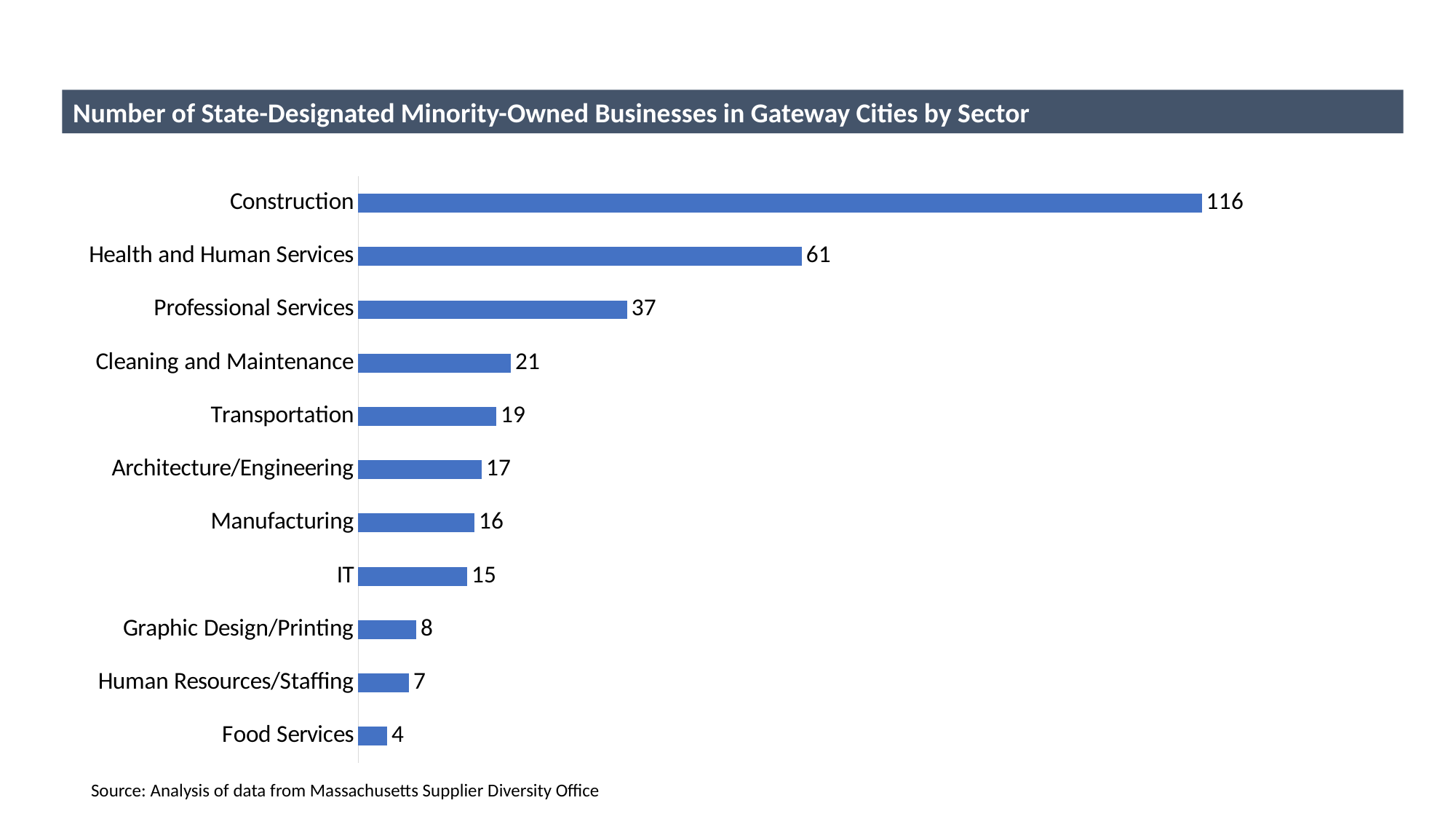
What is the title of the chart? Number of State-Designated Minority-Owned Businesses in Gateway Cities by Sector Which sector has the highest number of minority-owned businesses? Construction What is the value shown for Graphic Design/Printing? 8 How many sectors are shown in the chart? 11 What is the number of state-designated minority-owned businesses in the Construction sector? 116 Which has a larger value, Manufacturing or IT? Manufacturing What kind of chart is shown on the slide? Bar chart What is the difference between the values for Professional Services and Cleaning and Maintenance? 16 What is the difference between the values for Construction and Health and Human Services? 55 What is the value shown for Health and Human Services? 61 What is the value shown for Transportation? 19 Which sector has the lowest number of minority-owned businesses? Food Services